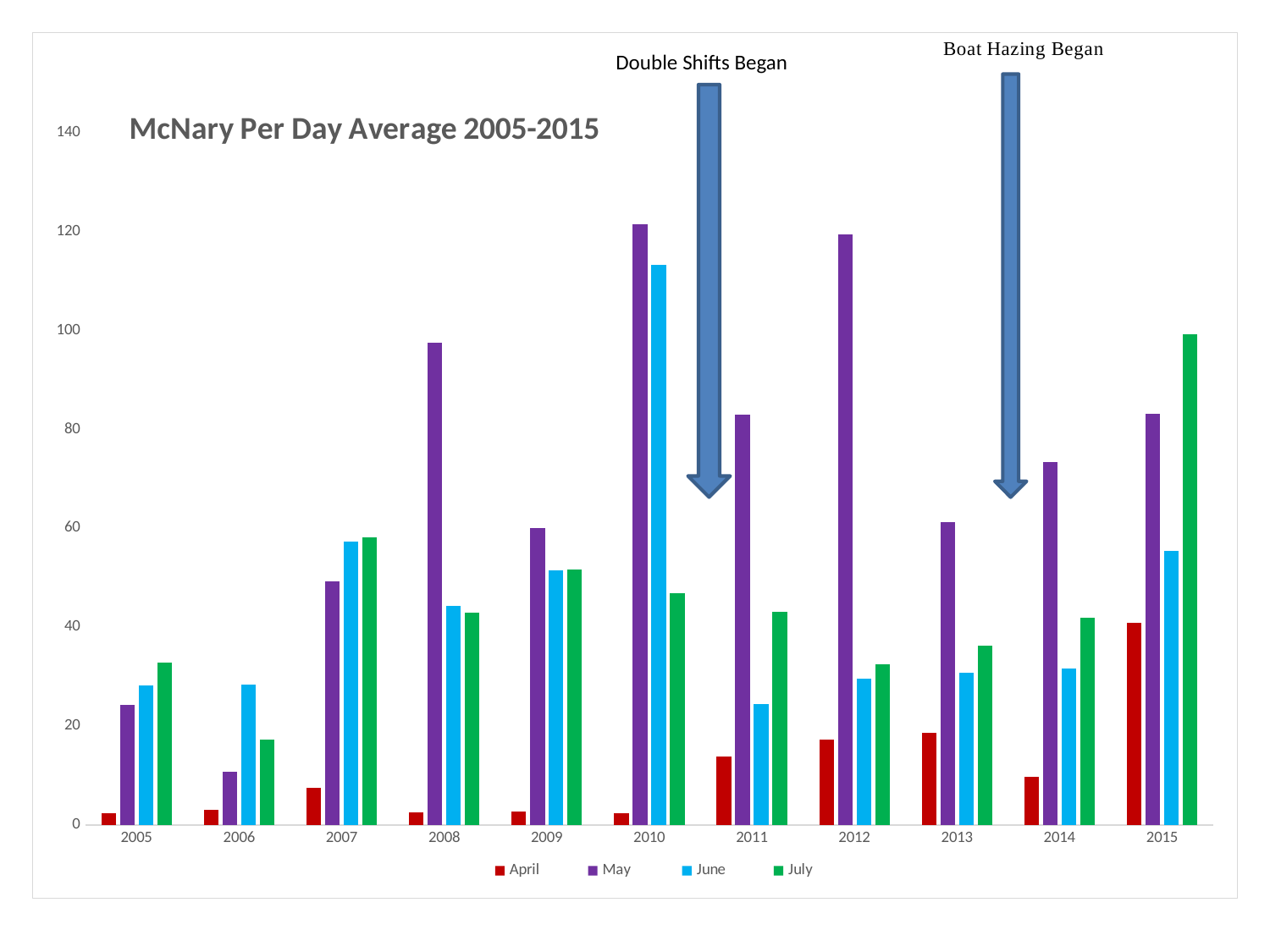
Is the July value for 2015 greater or less than 80? greater Is the June value for 2010 greater or less than 100? greater Do the July values rise or fall from 2012 to 2015? rise How many series does the legend list? 4 How many years are shown on the x axis? 11 What is the title of the chart? McNary Per Day Average 2005-2015 Is the April value for 2015 greater or less than 20? greater Which year has the highest July value? 2015 In 2008, which is larger, the May value or the June value? May In 2015, which is larger, the July value or the May value? July Which year has the lowest May value? 2006 What kind of chart is shown on the slide? bar chart